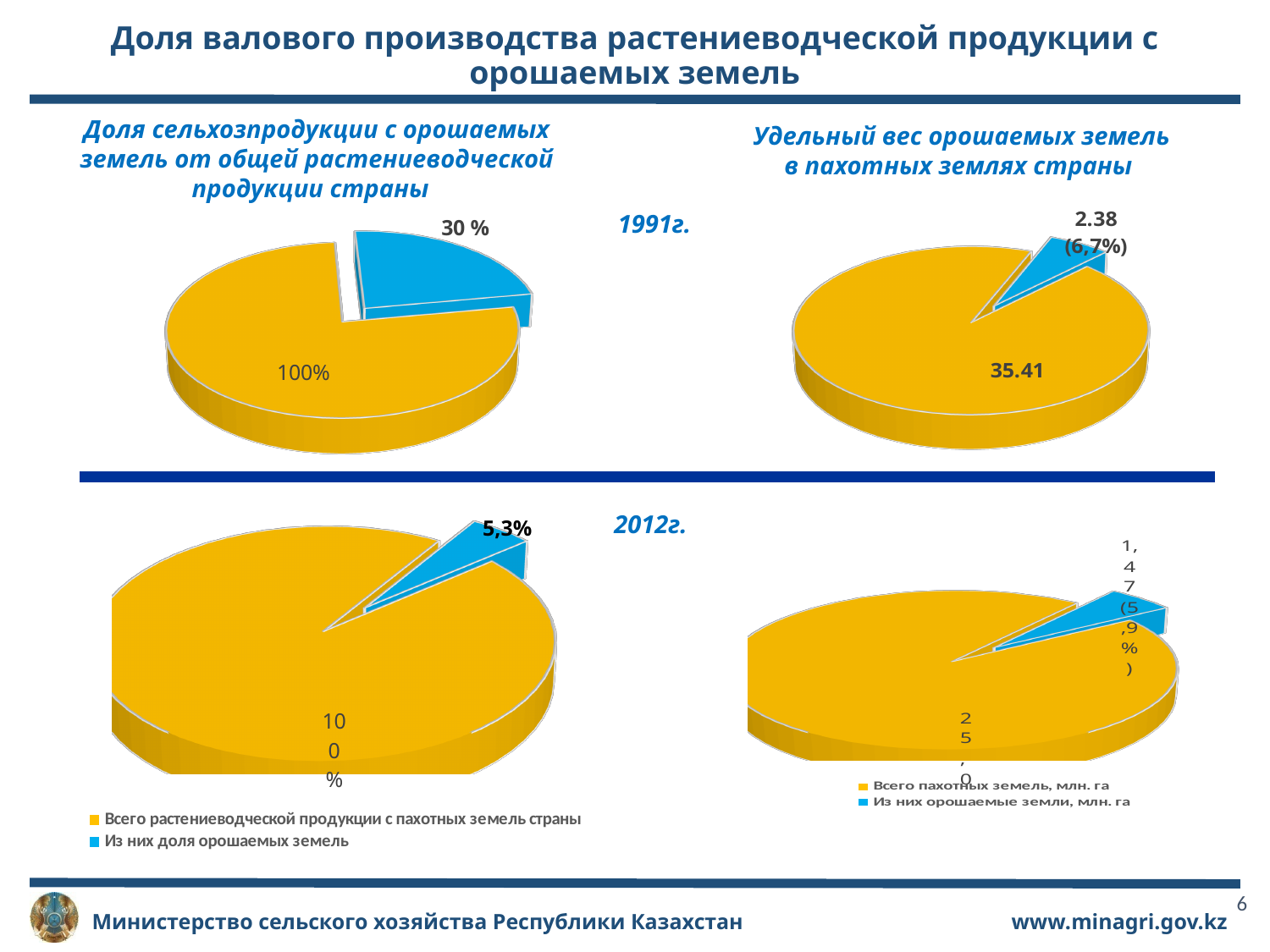
In the top-right pie chart (1991), which slice is larger, the yellow one or the blue one? The yellow one In the bottom-left pie chart (2012), what percentage is labelled on the blue slice? 5,3% In the top-right pie chart (1991), what value is labelled on the blue slice? 2.38 (6,7%) How many slices does the top-left pie chart (1991) have? 2 How many entries does the legend of the bottom-right pie chart (2012) list? 2 In the bottom-right pie chart (2012), what value is labelled on the blue slice? 1,47 (5,9%) In the bottom-left pie chart (2012), what does the legend say the blue slice represents? Из них доля орошаемых земель In the top-left pie chart (1991, share of agricultural products from irrigated lands), what value is labelled on the blue slice? 30 % In the top-right pie chart (1991, share of irrigated lands in arable lands), what value is labelled on the yellow slice? 35.41 What kind of charts are shown on the slide? Pie charts In the bottom-left pie chart (2012), which slice is the smallest? The blue slice (5,3%) In the top-left pie chart (1991), what value is labelled on the yellow slice? 100%